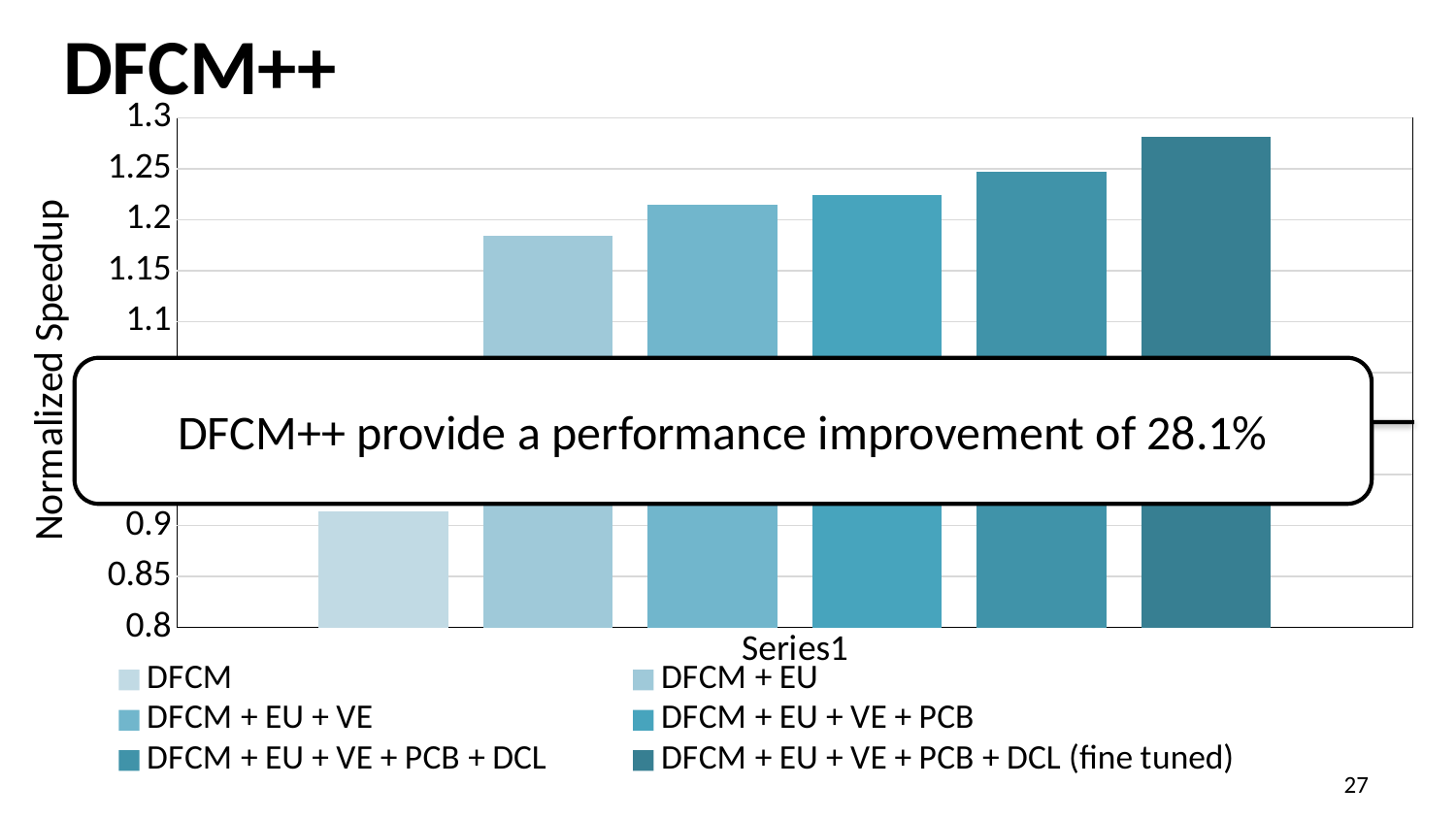
Which series has the lowest normalized speedup? DFCM Is the value for DFCM + EU greater or less than 1.15? greater How many series does the legend list? 6 Is the value for DFCM greater or less than 1.1? less Do the bar values rise or fall from left to right across the chart? rise Which is larger, the value for DFCM + EU or the value for DFCM + EU + VE + PCB + DCL? DFCM + EU + VE + PCB + DCL What is the label on the vertical axis of the chart? Normalized Speedup Which series has the highest normalized speedup? DFCM + EU + VE + PCB + DCL (fine tuned) Is the value for DFCM + EU greater or less than 1.2? less According to the callout on the slide, what performance improvement does DFCM++ provide? 28.1% What kind of chart is shown on the slide? bar chart